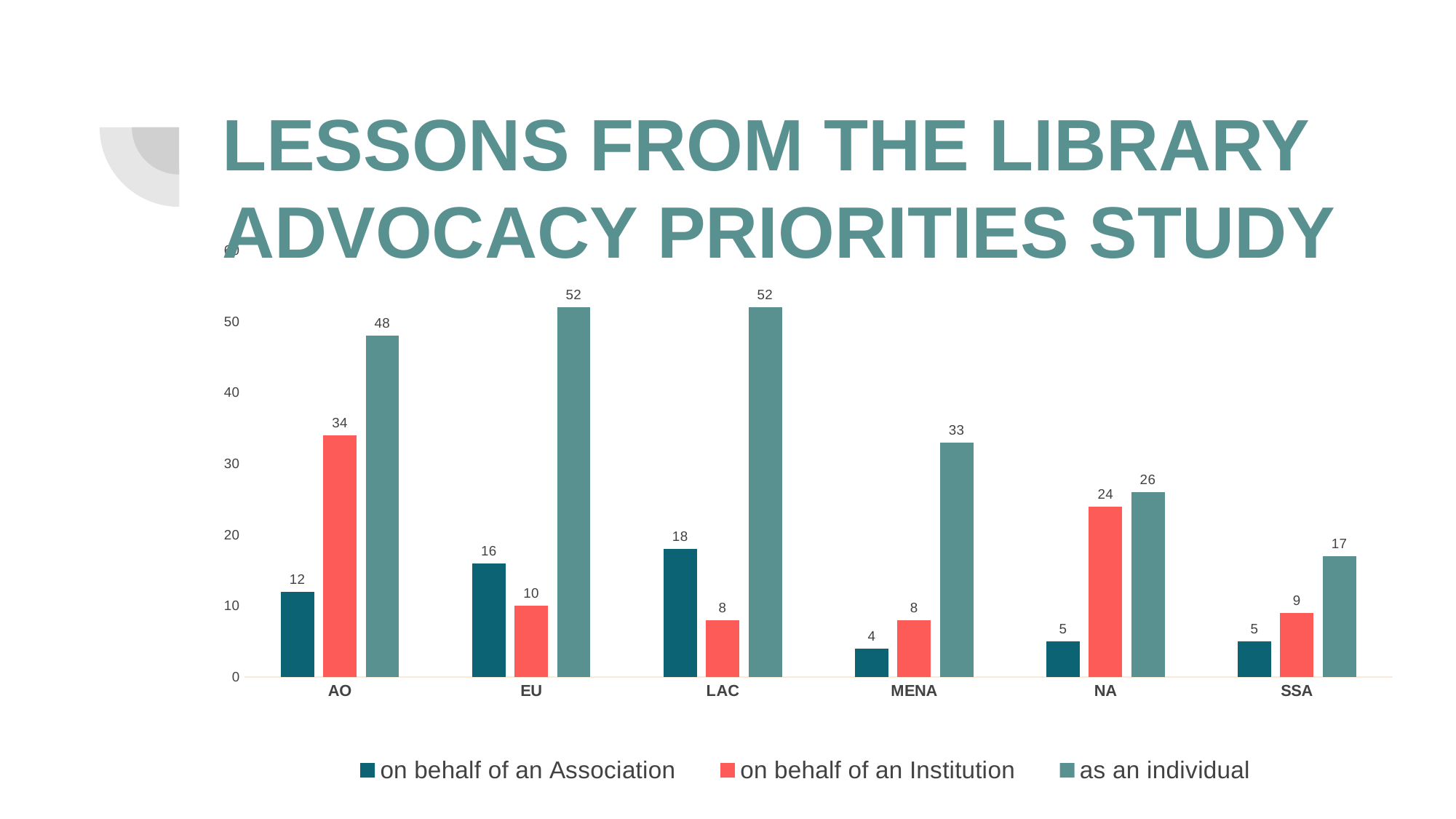
What kind of chart is shown on the slide? bar chart Which category has the highest value for 'on behalf of an Institution'? AO What is the value for 'as an individual' in the MENA category? 33 What is the difference between the 'as an individual' value and the 'on behalf of an Association' value in the EU category? 36 What is the value for 'on behalf of an Institution' in the AO category? 34 Which category has the lowest value for 'on behalf of an Association'? MENA In the NA category, which is larger: 'on behalf of an Institution' or 'on behalf of an Association'? on behalf of an Institution Is the value for 'as an individual' in the SSA category greater or less than 20? less What is the value for 'on behalf of an Association' in the LAC category? 18 What is the title of the slide containing the chart? LESSONS FROM THE LIBRARY ADVOCACY PRIORITIES STUDY How many series does the legend list? 3 How many categories are shown on the x axis? 6